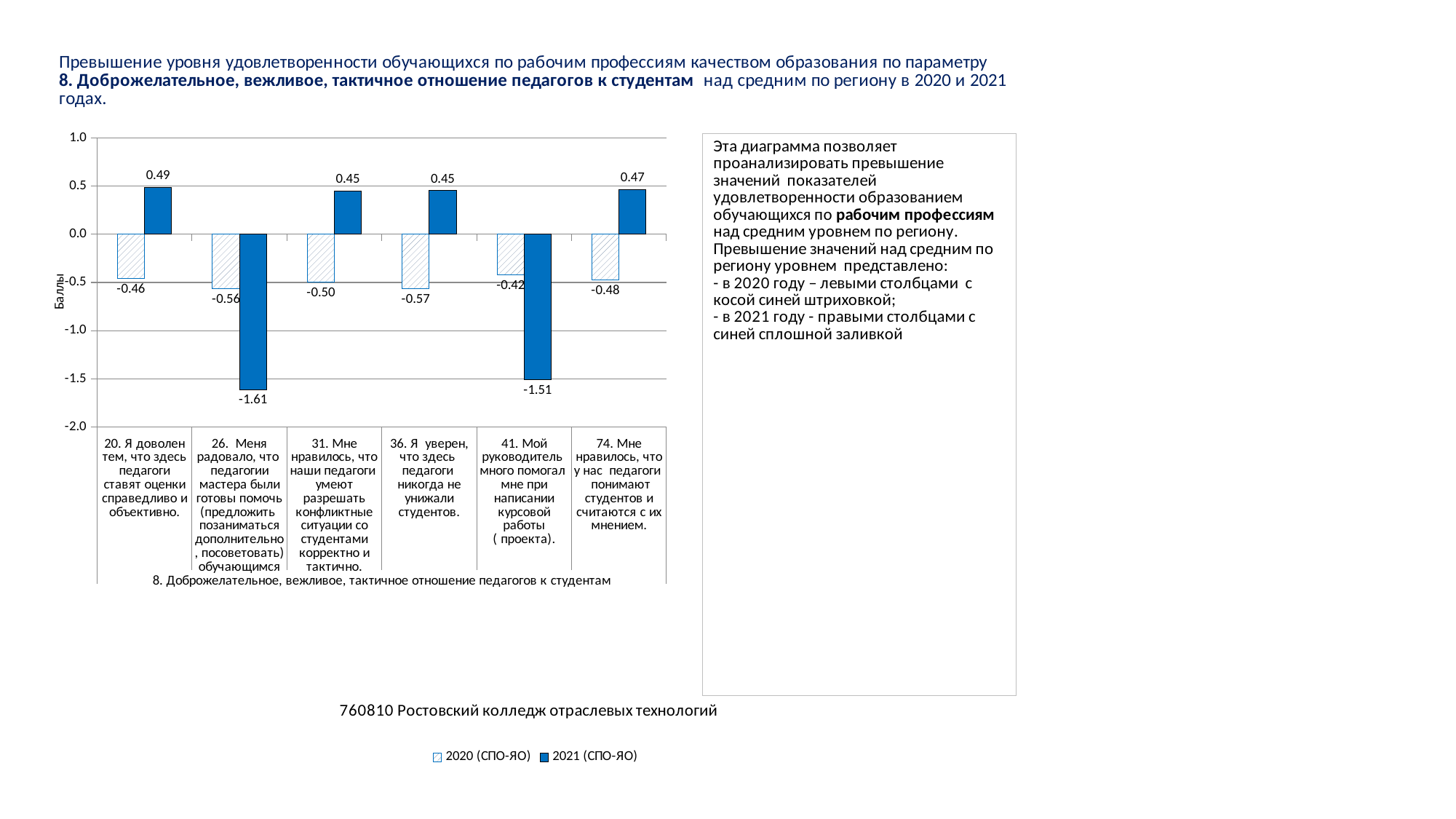
How many categories (questions) are shown on the x axis of the chart? 6 How many series does the chart legend list? 2 What is the 2020 (СПО-ЯО) value for category 36 (Я уверен, что здесь педагоги никогда не унижали студентов)? -0.57 Which category has the lowest 2021 (СПО-ЯО) value? 26. Меня радовало, что педагогии мастера были готовы помочь Which category has the highest 2021 (СПО-ЯО) value? 20. Я доволен тем, что здесь педагоги ставят оценки справедливо и объективно For category 41 (Мой руководитель много помогал мне при написании курсовой работы), which is larger: the 2020 (СПО-ЯО) value or the 2021 (СПО-ЯО) value? 2020 (СПО-ЯО) What is the difference between the 2021 (СПО-ЯО) and 2020 (СПО-ЯО) values for category 74 (Мне нравилось, что у нас педагоги понимают студентов)? 0.95 What is the 2021 (СПО-ЯО) value for category 20 (Я доволен тем, что здесь педагоги ставят оценки справедливо и объективно)? 0.49 Which category has the highest 2020 (СПО-ЯО) value? 41. Мой руководитель много помогал мне при написании курсовой работы (проекта) What is the 2021 (СПО-ЯО) value for category 26 (Меня радовало, что педагогии мастера были готовы помочь)? -1.61 What is the label of the vertical axis of the chart? Баллы What kind of chart is shown on the slide? bar chart